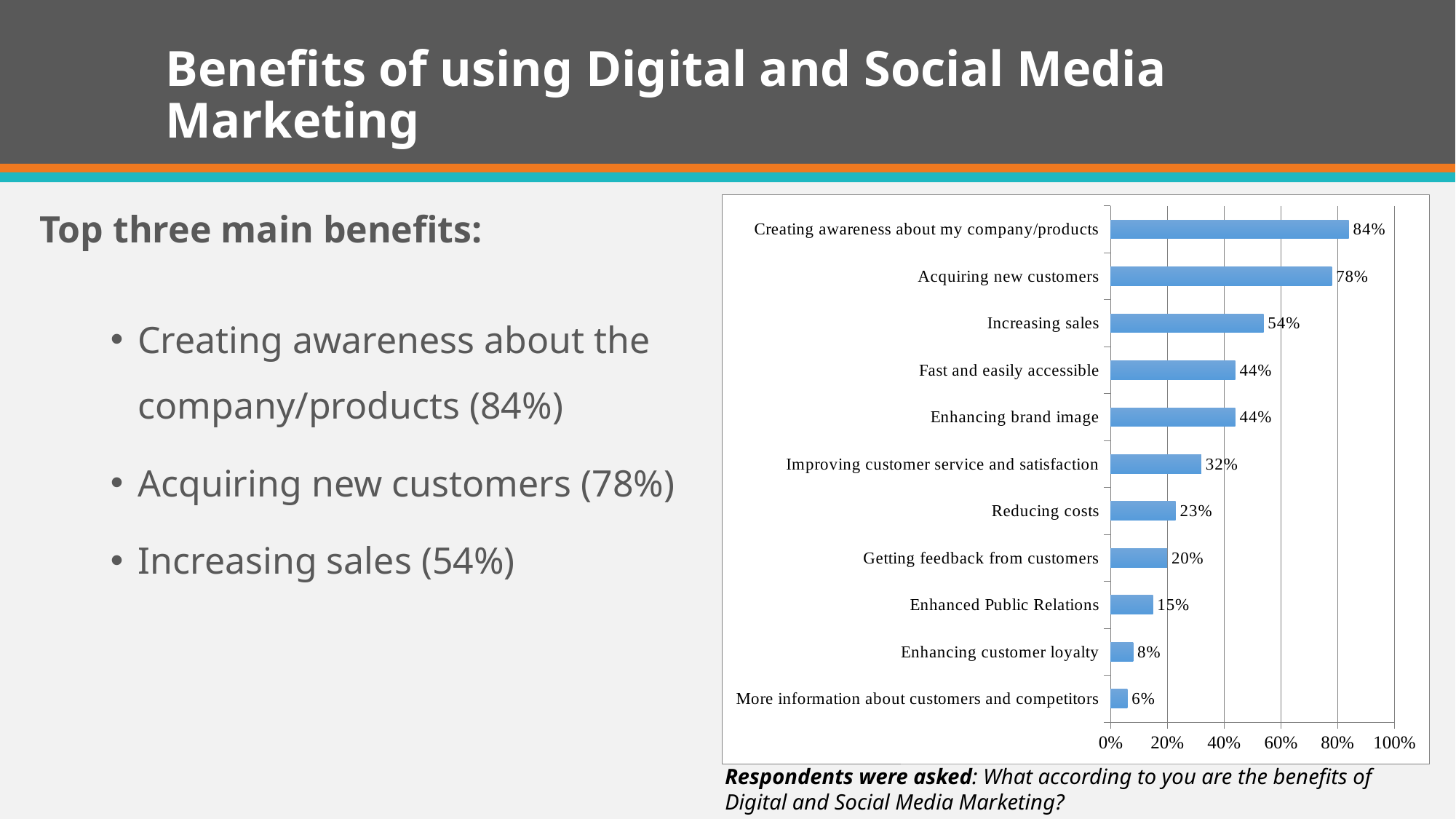
Which is larger: the value for 'Improving customer service and satisfaction' or the value for 'Getting feedback from customers'? Improving customer service and satisfaction What is the difference between the values for 'Acquiring new customers' and 'Increasing sales'? 24% What is the value shown for 'Enhanced Public Relations'? 15% Which two benefits share the same value of 44%? Fast and easily accessible; Enhancing brand image Is the value for 'Fast and easily accessible' greater or less than 40%? greater Which benefit has the lowest percentage in the chart? More information about customers and competitors How many benefit categories are shown in the chart? 11 What is the value shown for 'Reducing costs'? 23% What is the maximum value shown on the chart's horizontal axis? 100% Which benefit has the highest percentage in the chart? Creating awareness about my company/products What kind of chart is shown on the slide? Bar chart What percentage of respondents cited 'Creating awareness about my company/products' as a benefit? 84%